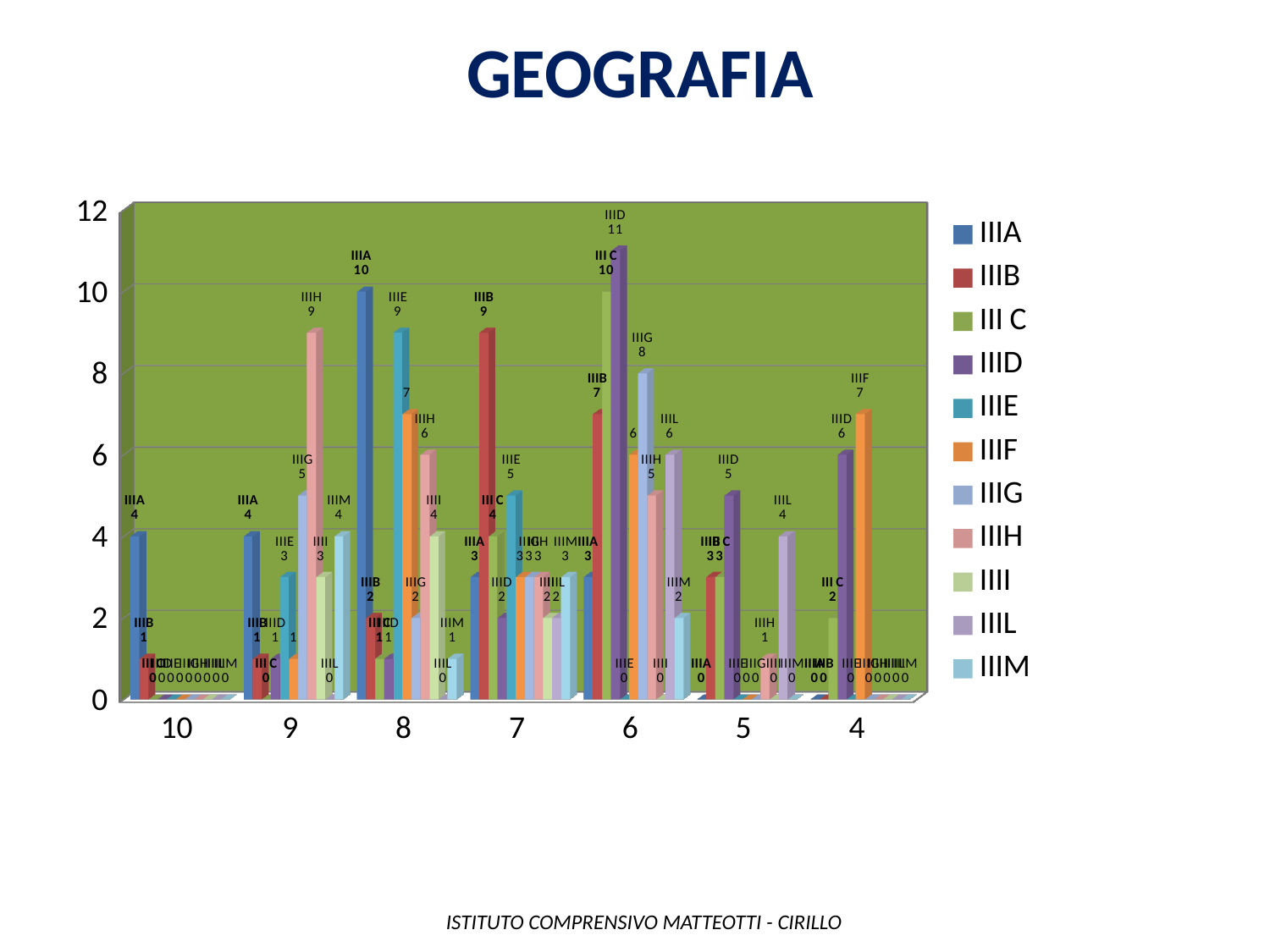
How many series does the legend list? 11 Which series has the highest value at category 8? IIIA What is the value for IIIG at category 6? 8 What is the value for IIIF at category 4? 7 What is the title of the chart? GEOGRAFIA What is the value for IIID at category 6? 11 How many categories are shown on the x axis? 7 Which is larger: IIID at category 5 or IIIL at category 5? IIID at category 5 What is the value for IIIH at category 9? 9 What is the value for IIIA at category 8? 10 What is the difference between IIIA at category 8 and IIIB at category 8? 8 Which series has the highest value at category 6? IIID